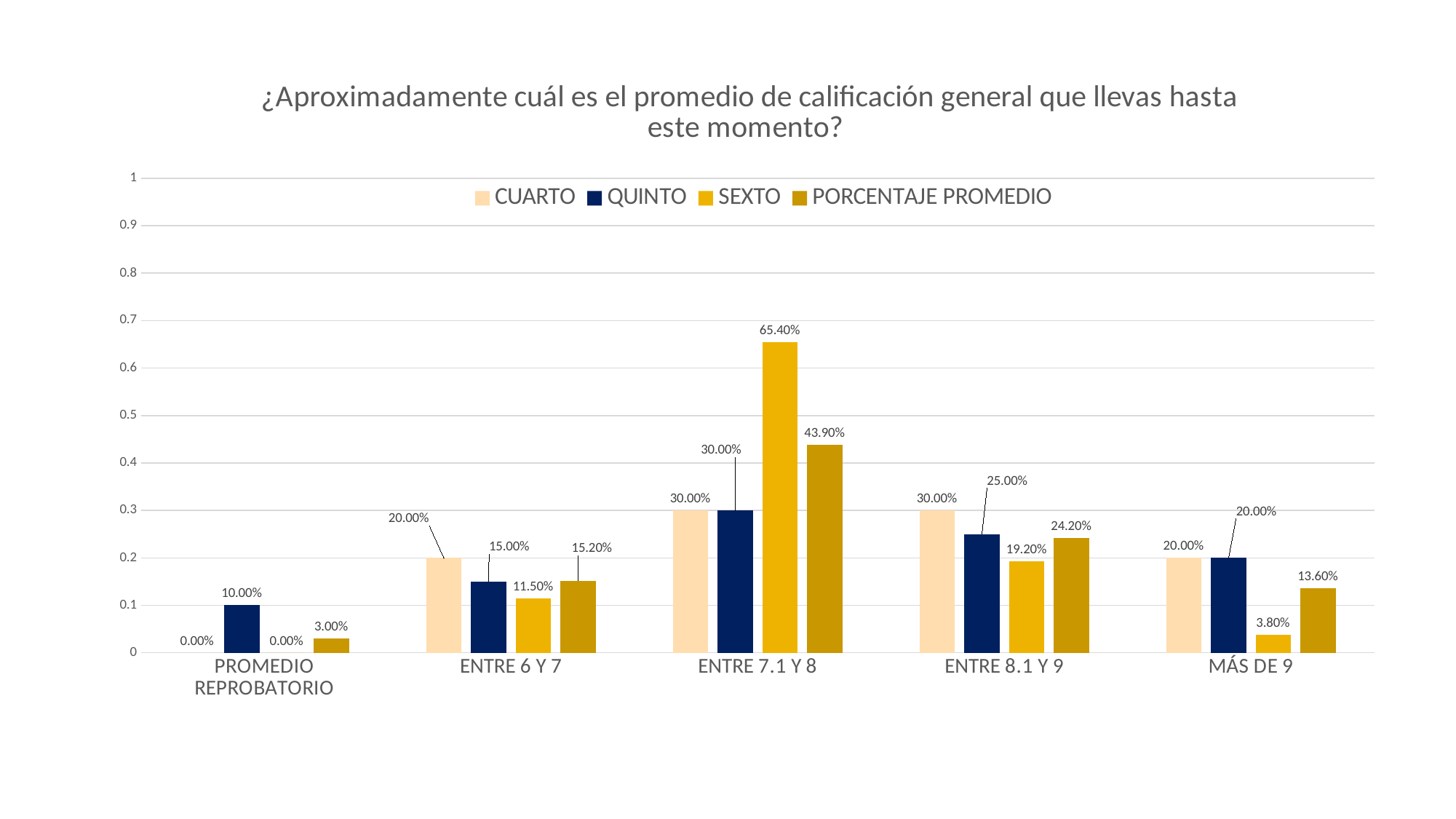
What is the value for SEXTO in the ENTRE 7.1 Y 8 category? 65.40% How many categories are shown on the x axis? 5 Which is larger in the ENTRE 8.1 Y 9 category, the QUINTO value or the SEXTO value? QUINTO How many series does the legend list? 4 What is the value for QUINTO in the PROMEDIO REPROBATORIO category? 10.00% Is the PORCENTAJE PROMEDIO value for ENTRE 7.1 Y 8 greater or less than 0.4? greater What kind of chart is shown on the slide? bar chart What is the PORCENTAJE PROMEDIO value for the MÁS DE 9 category? 13.60% What is the title of the chart? ¿Aproximadamente cuál es el promedio de calificación general que llevas hasta este momento? Which category has the lowest PORCENTAJE PROMEDIO value? PROMEDIO REPROBATORIO What is the difference between the SEXTO and QUINTO values in the ENTRE 7.1 Y 8 category? 35.40% Which category has the highest SEXTO value? ENTRE 7.1 Y 8